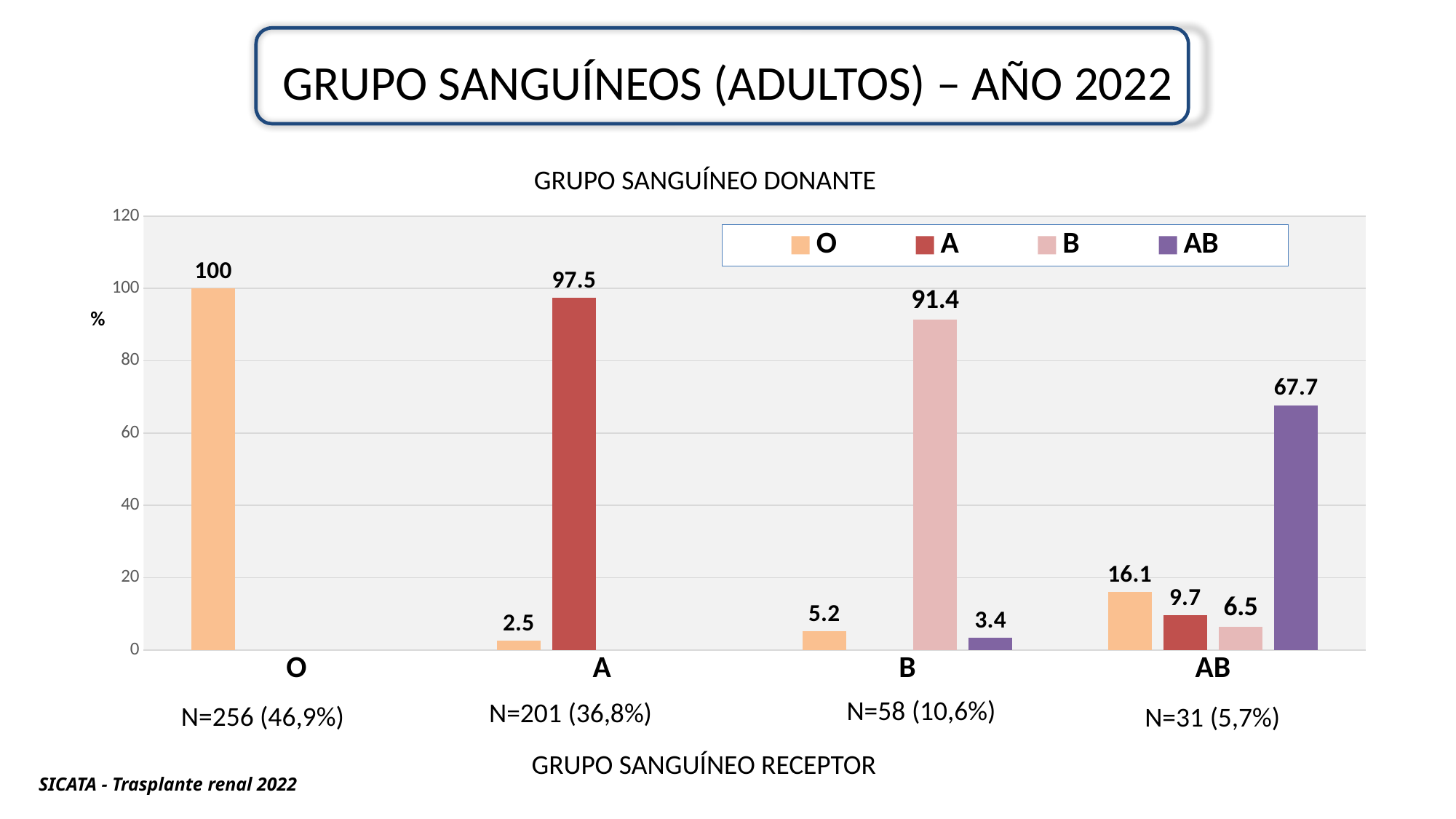
What is the N value shown for recipient blood group B? N=58 (10,6%) For recipient blood group A, what is the value for donor group A? 97.5 For recipient group AB, which is larger: the value for donor group O or donor group A? Donor group O Which recipient blood group has the highest value for donor group O? O What is the difference between the donor A value for recipient group A and the donor A value for recipient group AB? 87.8 What percentage of recipients with blood group O received a kidney from a donor with blood group O? 100 For recipient blood group B, what is the value for donor group O? 5.2 How many recipient blood group categories are shown on the x axis? 4 For recipient blood group AB, what is the value for donor group AB? 67.7 Within recipient group AB, which donor group has the lowest value? B How many series does the legend list? 4 What kind of chart is shown on the slide? Bar chart